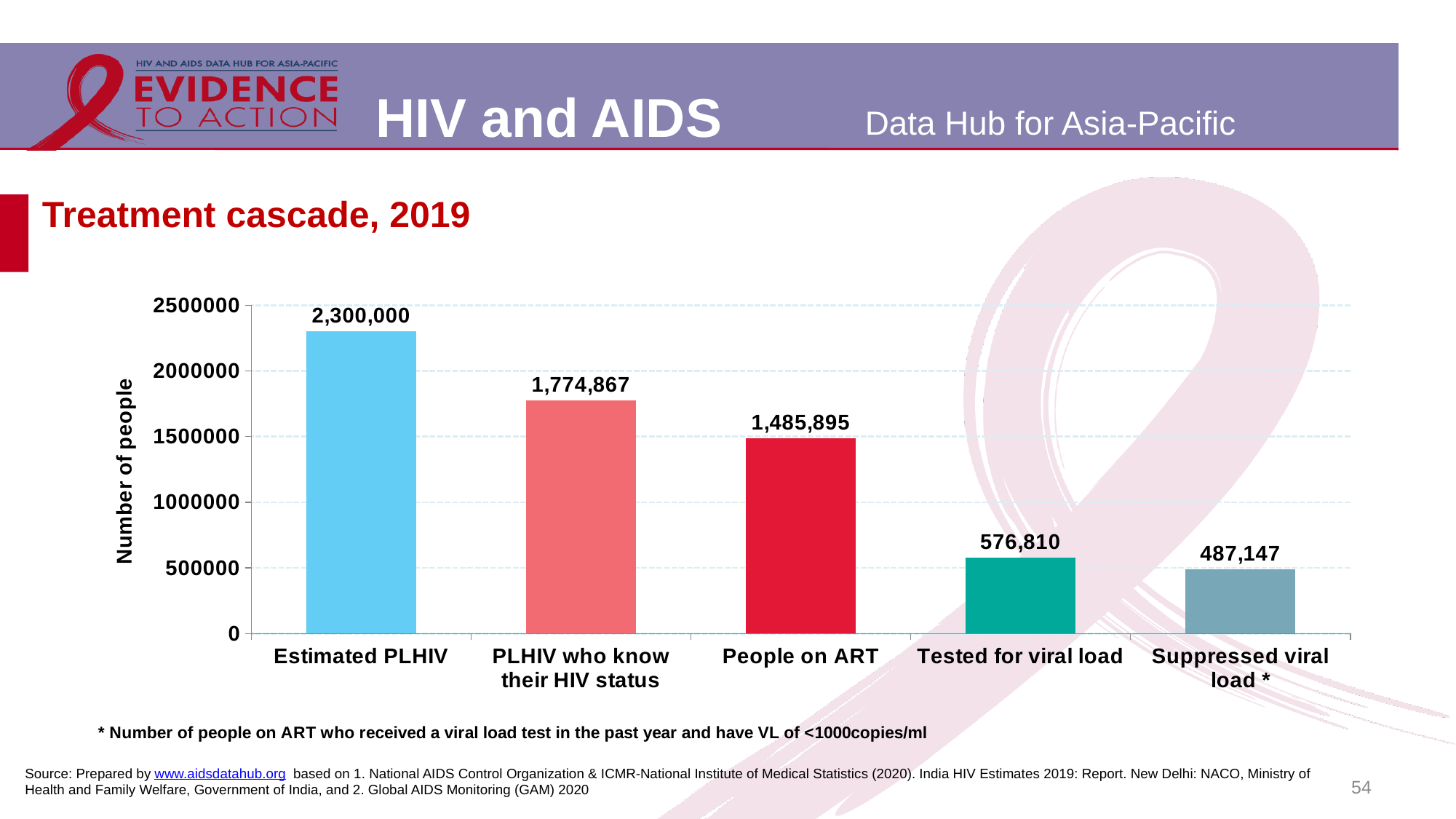
Do the values rise or fall from left to right along the x axis? fall What is the value for People on ART? 1,485,895 What is the difference between Estimated PLHIV and PLHIV who know their HIV status? 525,133 Which category has the highest value? Estimated PLHIV How many categories are shown on the x axis? 5 Which category has the lowest value? Suppressed viral load * What kind of chart is shown on the slide? bar chart What is the value for Suppressed viral load *? 487,147 Which is larger, PLHIV who know their HIV status or People on ART? PLHIV who know their HIV status Is the value for Tested for viral load greater or less than 1000000? less What is the difference between Tested for viral load and Suppressed viral load *? 89,663 What is the value for Estimated PLHIV? 2,300,000